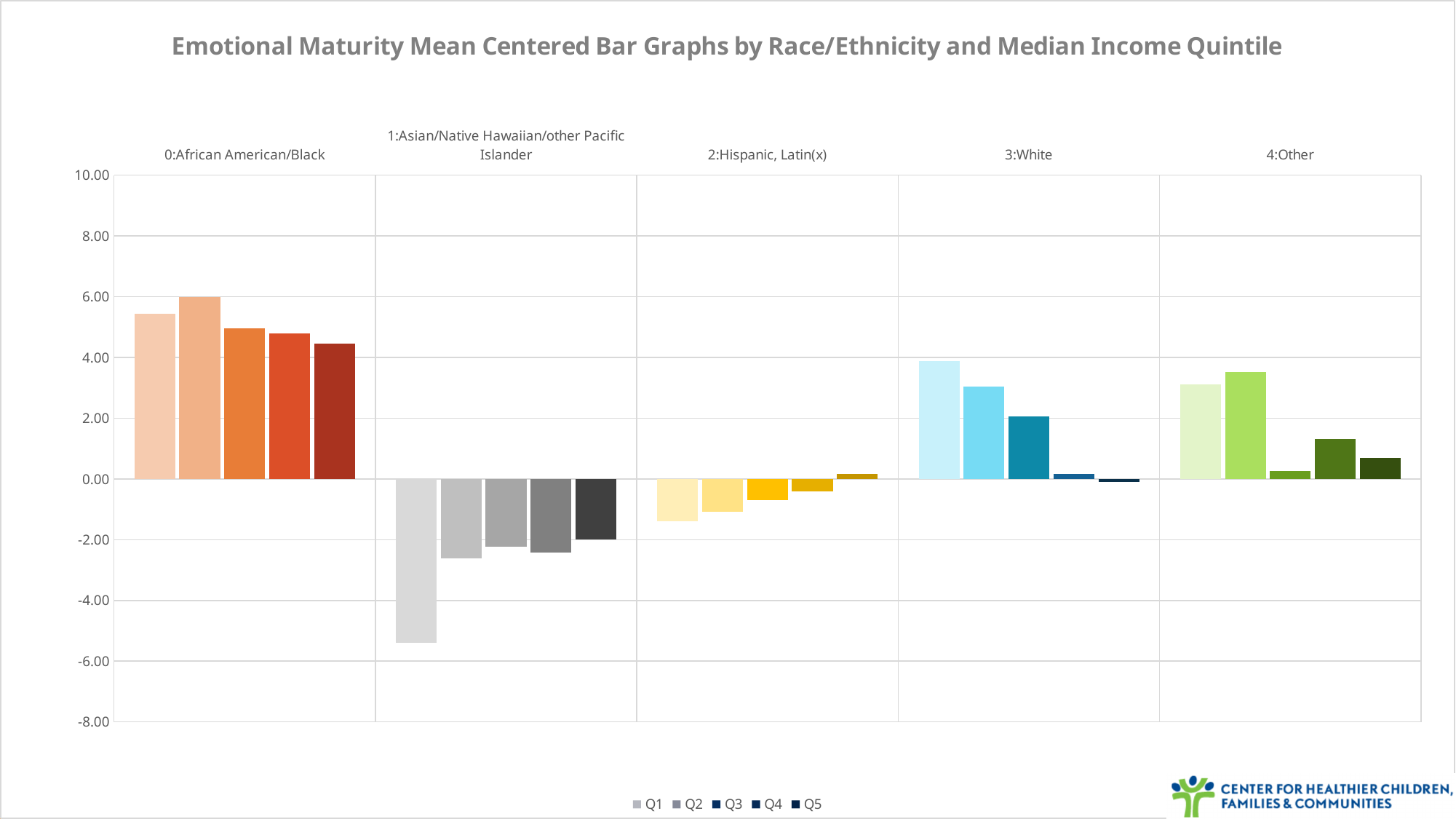
Which race/ethnicity group has the highest Q1 bar? 0:African American/Black What kind of chart is shown on the slide? bar chart Is the Q2 value for 3:White greater or less than 2.00? greater Which is larger, the Q1 value for 3:White or the Q1 value for 4:Other? 3:White What is the title of the chart? Emotional Maturity Mean Centered Bar Graphs by Race/Ethnicity and Median Income Quintile Is the Q4 value for 4:Other greater or less than 2.00? less Which race/ethnicity group has the lowest bar on the chart? 1:Asian/Native Hawaiian/other Pacific Islander Is the Q1 value for 0:African American/Black greater or less than 4.00? greater How many race/ethnicity groups are shown along the x axis? 5 Do the bars for 2:Hispanic, Latin(x) rise or fall from Q1 to Q5? rise How many series does the legend list? 5